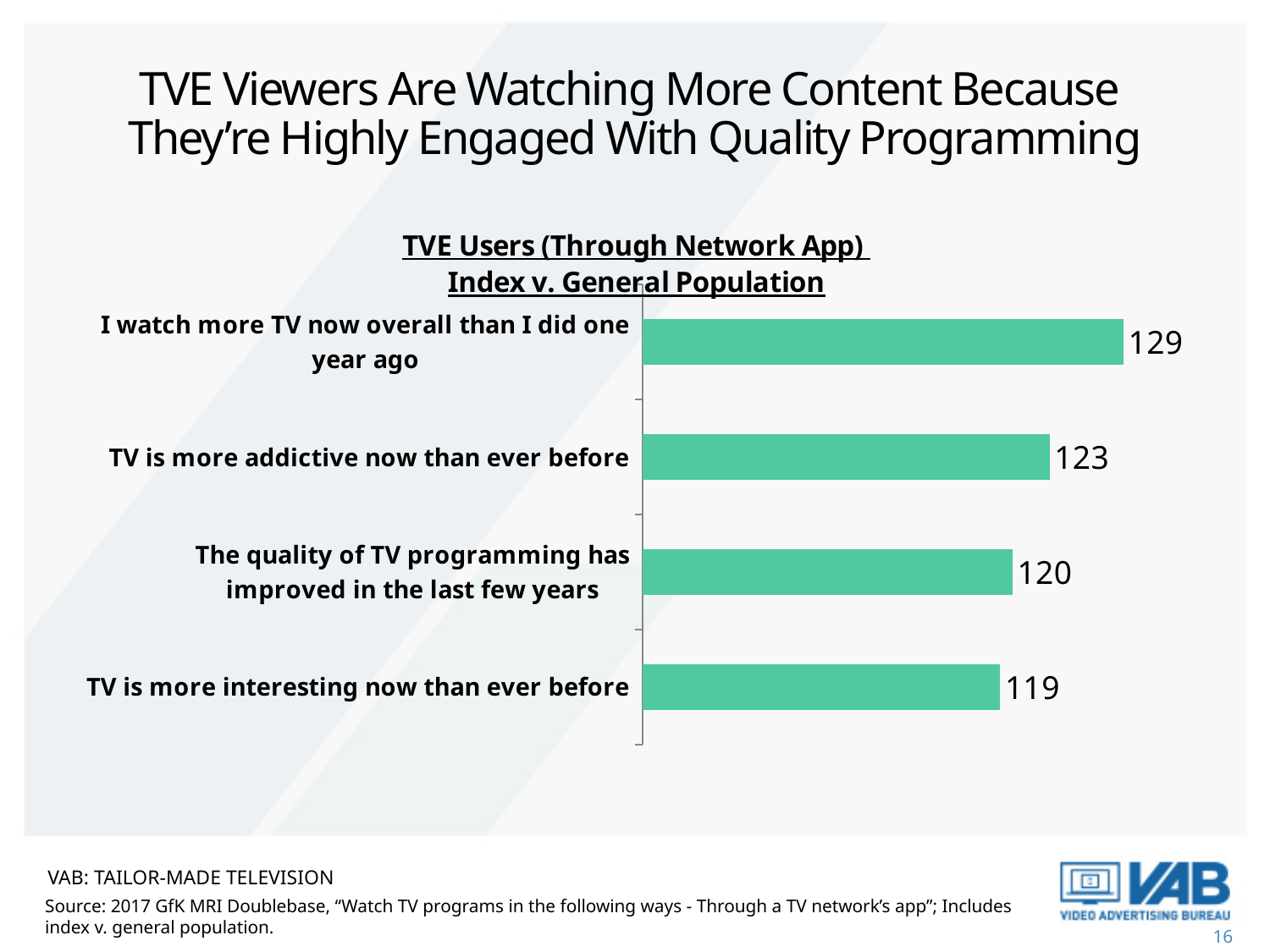
What is the difference between the index for "I watch more TV now overall than I did one year ago" and "TV is more interesting now than ever before"? 10 Which statement has the highest index value? I watch more TV now overall than I did one year ago What is the difference between the index for "TV is more addictive now than ever before" and "The quality of TV programming has improved in the last few years"? 3 Which statement has the lowest index value? TV is more interesting now than ever before What is the index value for "TV is more addictive now than ever before"? 123 What is the title of the chart? TVE Users (Through Network App) Index v. General Population What is the index value for "I watch more TV now overall than I did one year ago"? 129 What is the index value for "TV is more interesting now than ever before"? 119 Which has a higher index: "TV is more addictive now than ever before" or "The quality of TV programming has improved in the last few years"? TV is more addictive now than ever before What type of chart is shown on the slide? Bar chart What is the index value for "The quality of TV programming has improved in the last few years"? 120 How many statements are shown in the chart? 4